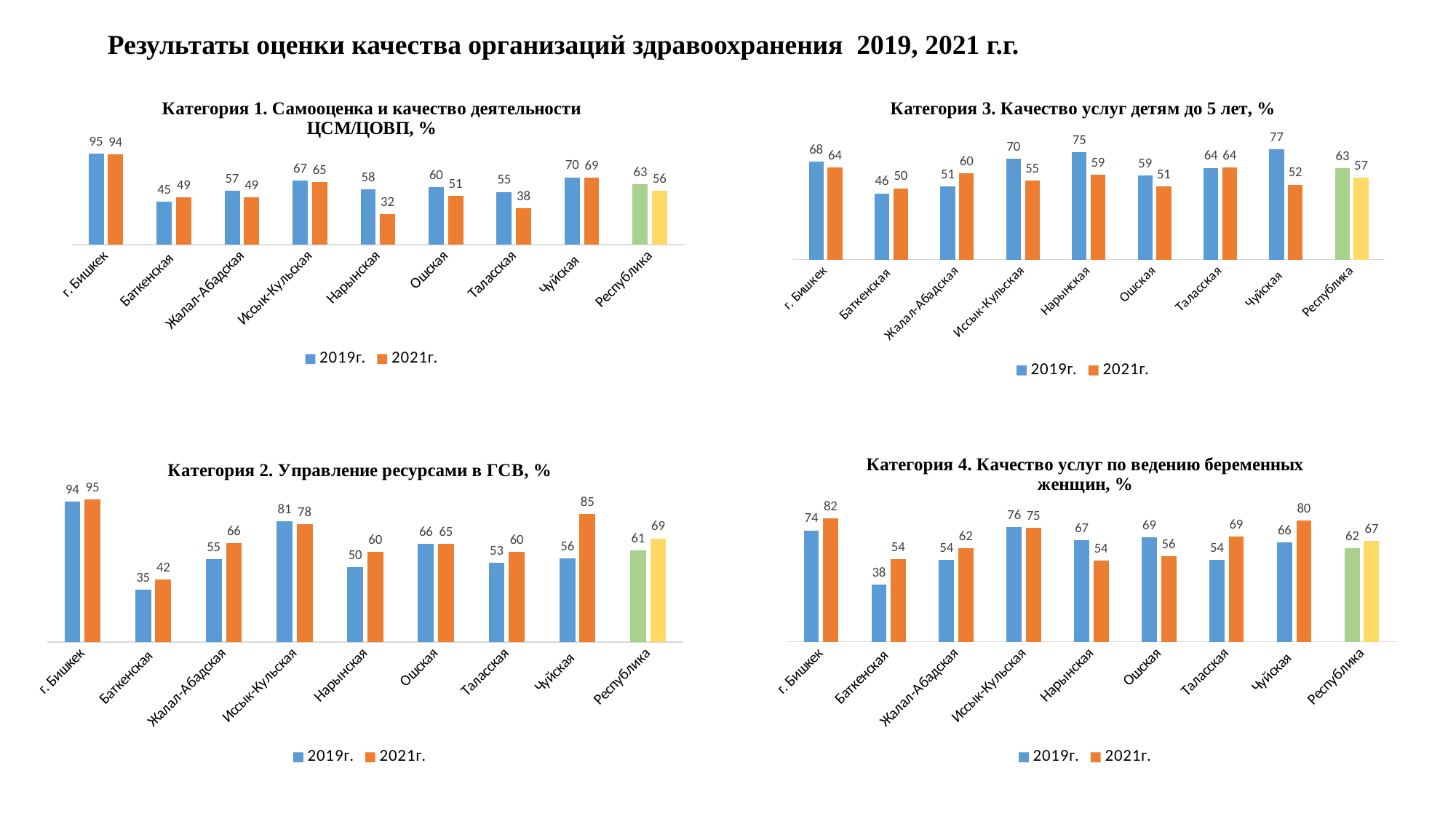
In the chart 'Категория 2. Управление ресурсами в ГСВ, %', what is the value for Чуйская in 2021г.? 85 In the chart 'Категория 3. Качество услуг детям до 5 лет, %', what is the difference between the 2019г. and 2021г. values for Чуйская? 25 In the chart 'Категория 4. Качество услуг по ведению беременных женщин, %', what is the difference between the 2021г. and 2019г. values for Баткенская? 16 In the chart 'Категория 1. Самооценка и качество деятельности ЦСМ/ЦОВП, %', what is the value for Нарынская in 2021г.? 32 In the chart 'Категория 1. Самооценка и качество деятельности ЦСМ/ЦОВП, %', which region has the highest value for 2019г.? г. Бишкек In the chart 'Категория 3. Качество услуг детям до 5 лет, %', which region has the lowest value for 2019г.? Баткенская In the chart 'Категория 2. Управление ресурсами в ГСВ, %', which region has the lowest value for 2021г.? Баткенская In the chart 'Категория 4. Качество услуг по ведению беременных женщин, %', what is the value for Республика in 2021г.? 67 How many series does the legend list in the chart 'Категория 1. Самооценка и качество деятельности ЦСМ/ЦОВП, %'? 2 In the chart 'Категория 2. Управление ресурсами в ГСВ, %', which is larger for Иссык-Кульская: the 2019г. value or the 2021г. value? 2019г. How many regions (categories) are shown on the x axis of the chart 'Категория 4. Качество услуг по ведению беременных женщин, %'? 9 In the chart 'Категория 3. Качество услуг детям до 5 лет, %', what is the value for Чуйская in 2019г.? 77